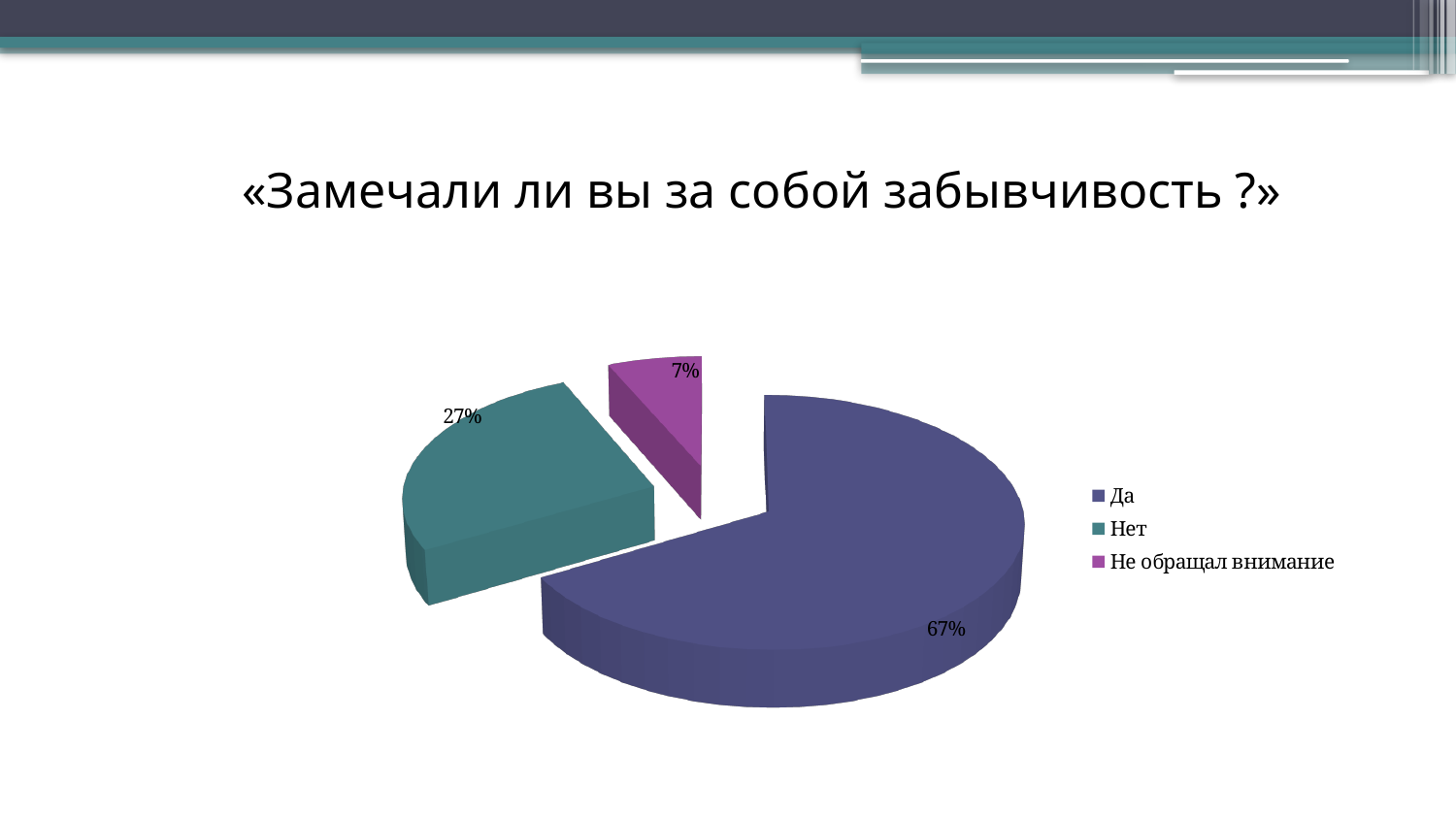
What kind of chart is shown on the slide? Pie chart Which category has the smallest slice of the pie? Не обращал внимание What is the difference in percentage points between the "Нет" and "Не обращал внимание" slices? 20 What is the difference in percentage points between the "Да" and "Нет" slices? 40 How many categories are shown in the pie chart? 3 Which slice is larger, "Нет" or "Не обращал внимание"? Нет Which category has the largest slice of the pie? Да What share of the pie does "Не обращал внимание" represent? 7% What share of the pie does "Нет" represent? 27% What share of the pie does "Да" represent? 67% What is the title of the slide above the chart? «Замечали ли вы за собой забывчивость ?» Which category is shown in purple/magenta in the legend? Не обращал внимание